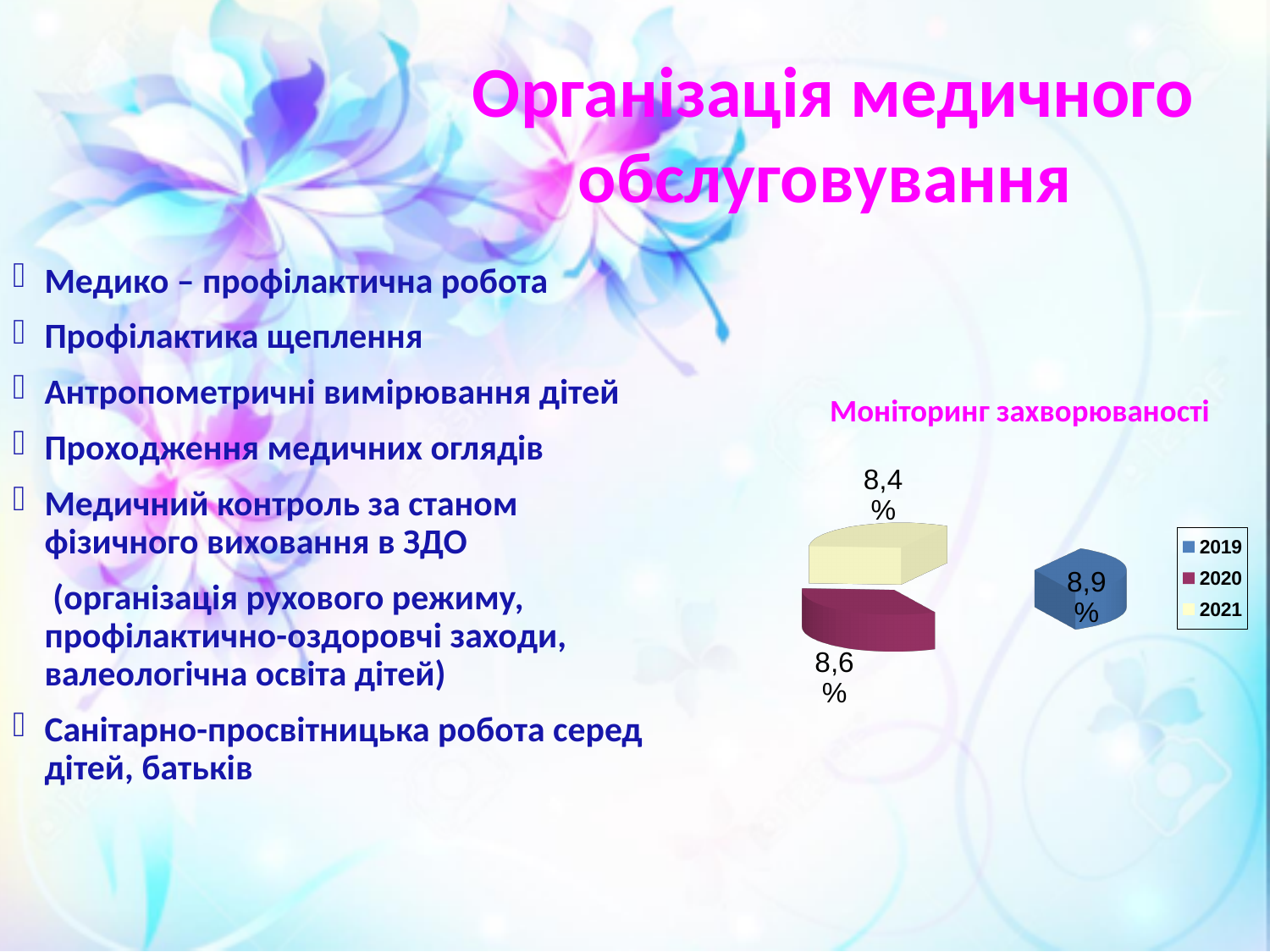
Which year has the lowest value in the chart? 2021 What is the value shown for 2020 in the chart? 8,6% What is the difference between the values for 2019 and 2021? 0,5% What is the value shown for 2021 in the chart? 8,4% What is the value shown for 2019 in the chart? 8,9% Which year has the highest value in the chart? 2019 What is the difference between the values for 2020 and 2021? 0,2% What kind of chart is shown on the slide? Pie chart What is the title of the chart? Моніторинг захворюваності How many slices does the pie chart have? 3 Which is larger, the value for 2019 or the value for 2020? 2019 How many entries does the chart legend list? 3